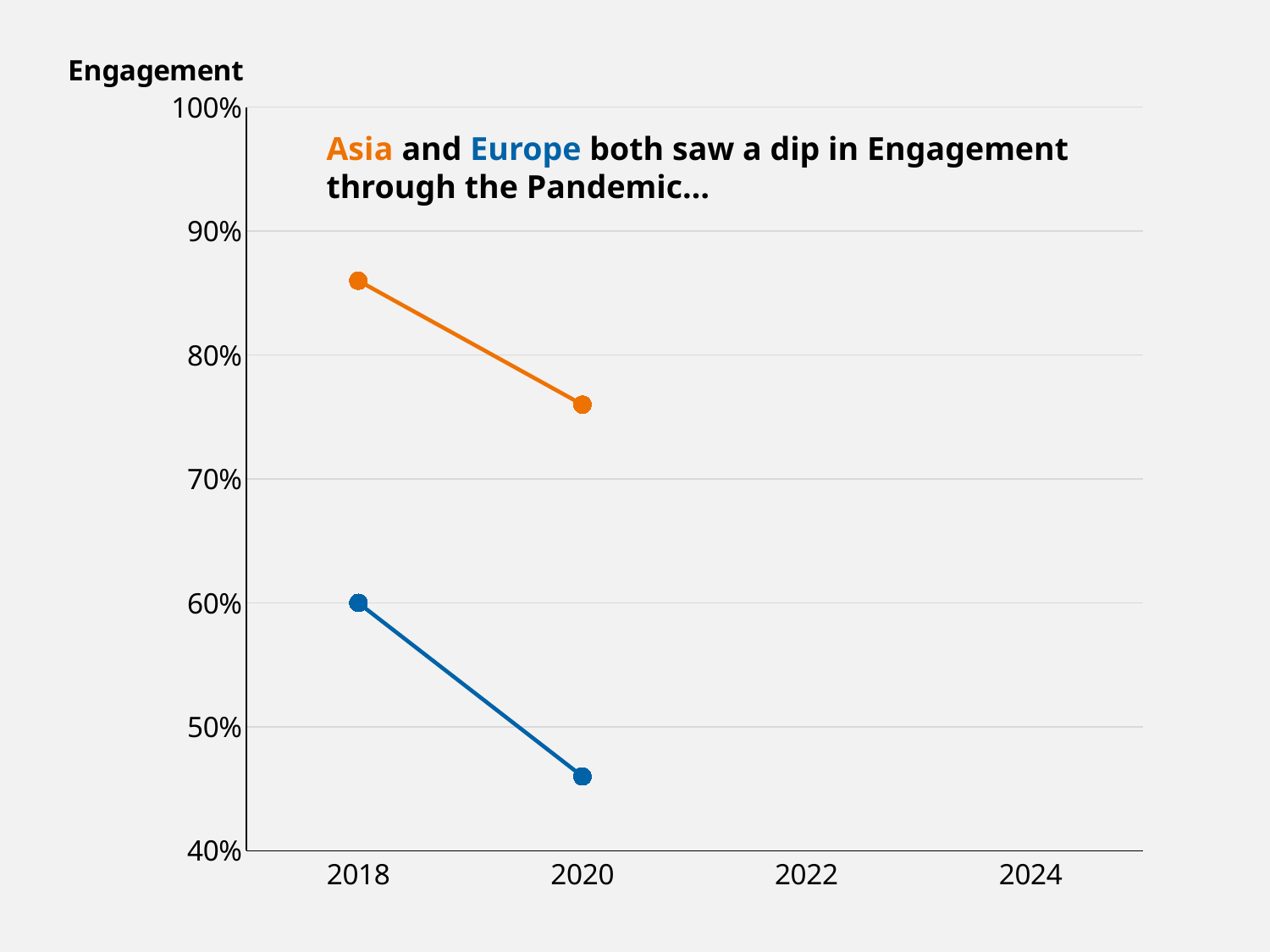
How many years are labelled on the x axis? 4 Which region has the higher Engagement in 2018, Asia or Europe? Asia What colour is the line for Asia? orange Is the Engagement value for Asia in 2018 greater or less than 80%? greater Is the Engagement value for Asia in 2020 greater or less than 80%? less Is the Engagement value for Europe in 2020 greater or less than 50%? less What kind of chart is shown on the slide? line chart Which region has the lower Engagement in 2020, Asia or Europe? Europe Does Europe's Engagement rise or fall from 2018 to 2020? fall Does Asia's Engagement rise or fall from 2018 to 2020? fall How many series are plotted on the chart? 2 What is the Engagement value for Europe in 2018? 60%